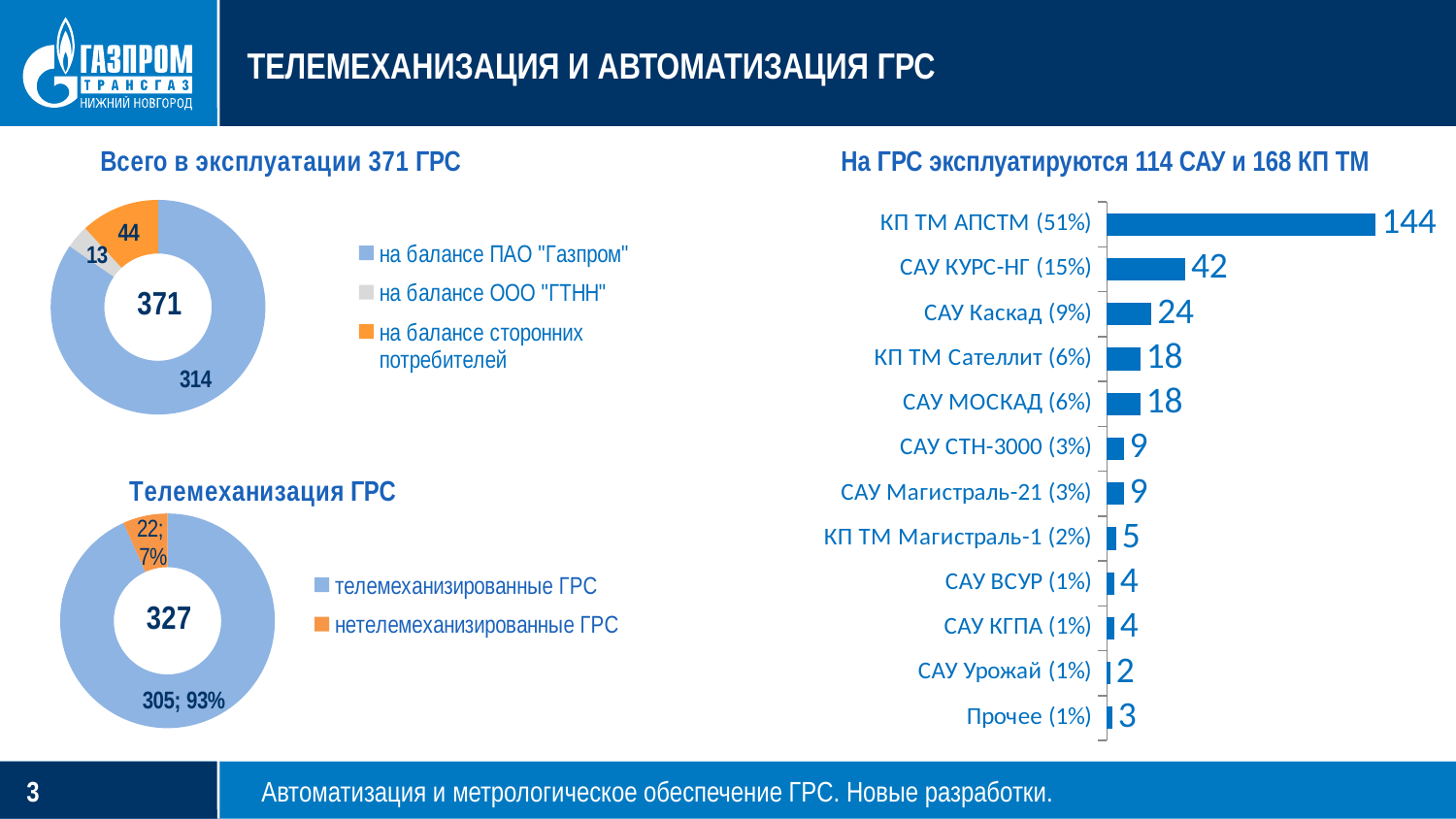
How many categories are shown in the bar chart titled "На ГРС эксплуатируются 114 САУ и 168 КП ТМ"? 12 In the bar chart titled "На ГРС эксплуатируются 114 САУ и 168 КП ТМ", what is the value for САУ Каскад? 24 In the bar chart titled "На ГРС эксплуатируются 114 САУ и 168 КП ТМ", what is the value for КП ТМ АПСТМ? 144 In the bar chart titled "На ГРС эксплуатируются 114 САУ и 168 КП ТМ", which is larger: САУ СТН-3000 or КП ТМ Магистраль-1? САУ СТН-3000 What kind of chart is the chart titled "На ГРС эксплуатируются 114 САУ и 168 КП ТМ"? bar chart In the donut chart titled "Всего в эксплуатации 371 ГРС", what is the value for "на балансе ПАО "Газпром""? 314 In the bar chart titled "На ГРС эксплуатируются 114 САУ и 168 КП ТМ", what is the difference between the values for КП ТМ АПСТМ and САУ КУРС-НГ? 102 In the donut chart titled "Всего в эксплуатации 371 ГРС", what is the value for "на балансе сторонних потребителей"? 44 In the bar chart titled "На ГРС эксплуатируются 114 САУ и 168 КП ТМ", which category has the highest value? КП ТМ АПСТМ In the donut chart titled "Телемеханизация ГРС", what share do нетелемеханизированные ГРС make up? 7% In the bar chart titled "На ГРС эксплуатируются 114 САУ и 168 КП ТМ", which category has the lowest value? САУ Урожай How many entries does the legend of the donut chart titled "Всего в эксплуатации 371 ГРС" list? 3